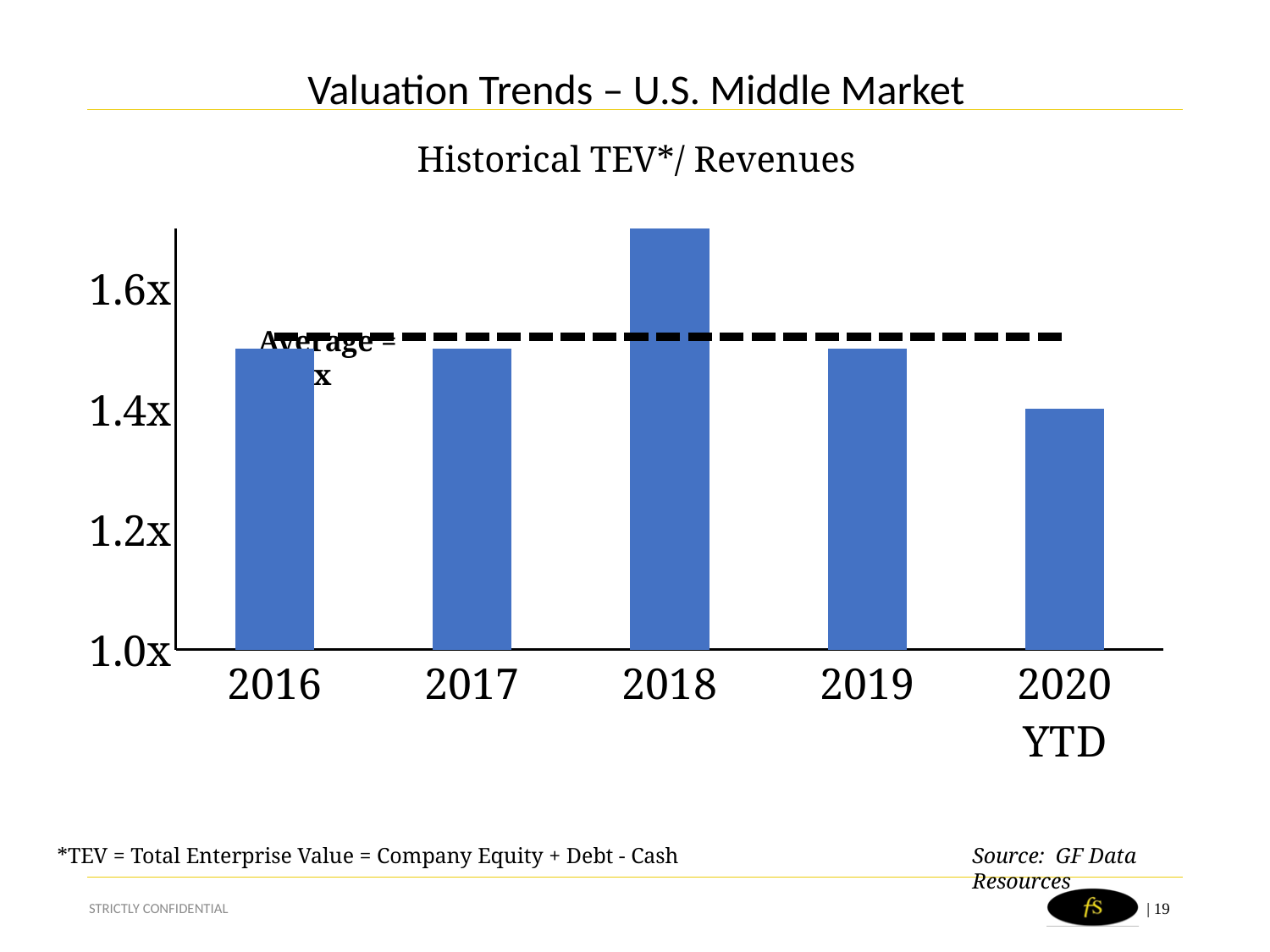
What kind of chart is shown on the slide? bar chart Which category has the lowest TEV/Revenues multiple? 2020 YTD Do the values rise or fall from 2018 to 2020 YTD? fall Which is larger, the value for 2018 or the value for 2020 YTD? 2018 Is the value for 2019 greater or less than 1.6x? less Is the value for 2018 greater or less than 1.6x? greater What is the title of the chart? Historical TEV*/ Revenues Is the value for 2016 greater or less than 1.4x? greater Which year has the highest TEV/Revenues multiple? 2018 How many categories are shown on the x axis of the chart? 5 What does the dashed horizontal line across the chart represent? Average